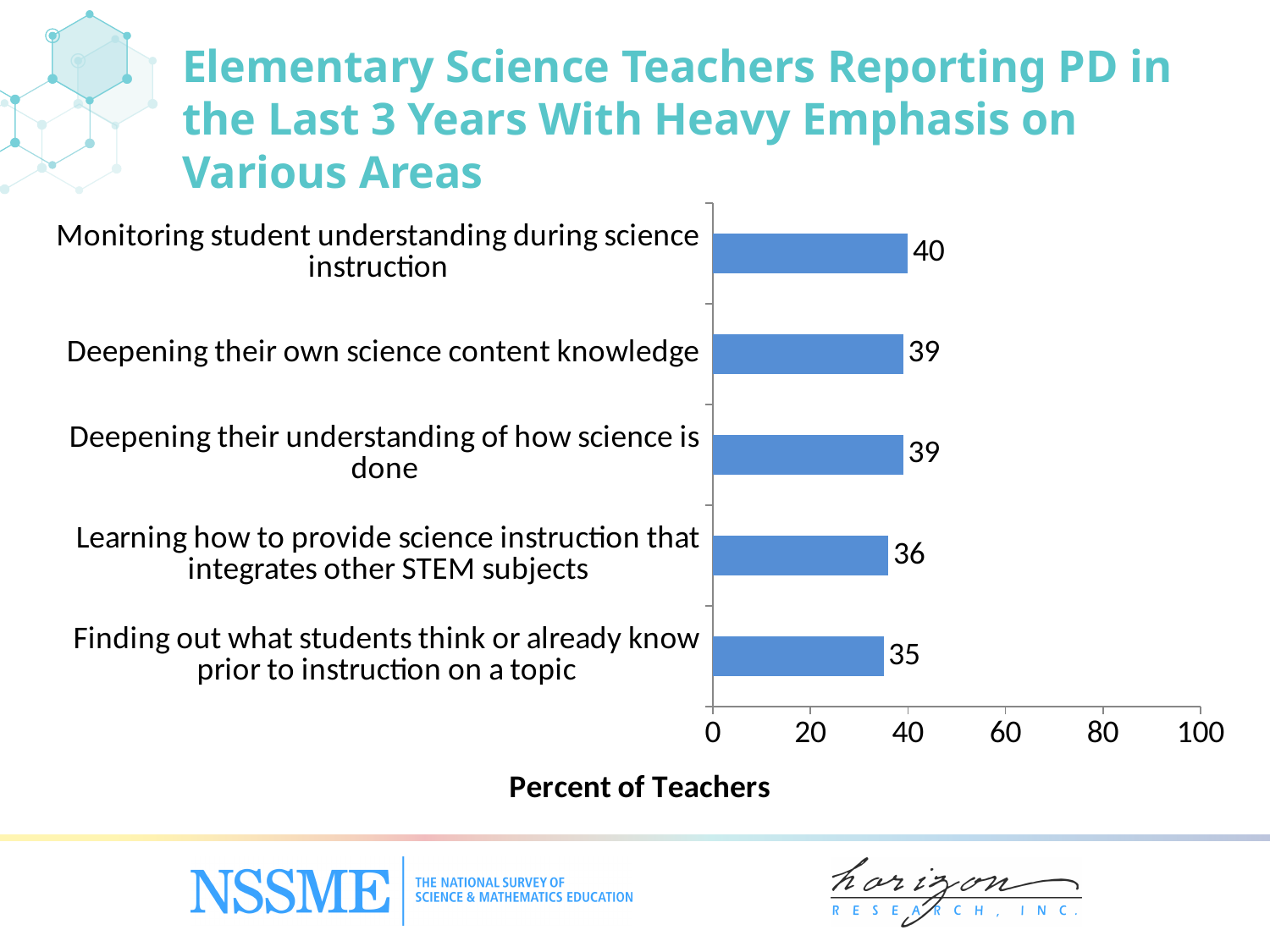
What is the difference between the values for 'Monitoring student understanding during science instruction' and 'Finding out what students think or already know prior to instruction on a topic'? 5 Is the value for 'Deepening their own science content knowledge' greater or less than 60? less What percent of teachers reported PD with heavy emphasis on monitoring student understanding during science instruction? 40 How many areas (categories) are shown in the chart? 5 What kind of chart is shown on the slide? bar chart What is the value for 'Learning how to provide science instruction that integrates other STEM subjects'? 36 Which is larger: the value for 'Deepening their understanding of how science is done' or the value for 'Learning how to provide science instruction that integrates other STEM subjects'? Deepening their understanding of how science is done What is the value for 'Deepening their own science content knowledge'? 39 Which area has the lowest percent of teachers? Finding out what students think or already know prior to instruction on a topic What is the label of the horizontal axis? Percent of Teachers What is the value for 'Finding out what students think or already know prior to instruction on a topic'? 35 Which area has the highest percent of teachers? Monitoring student understanding during science instruction